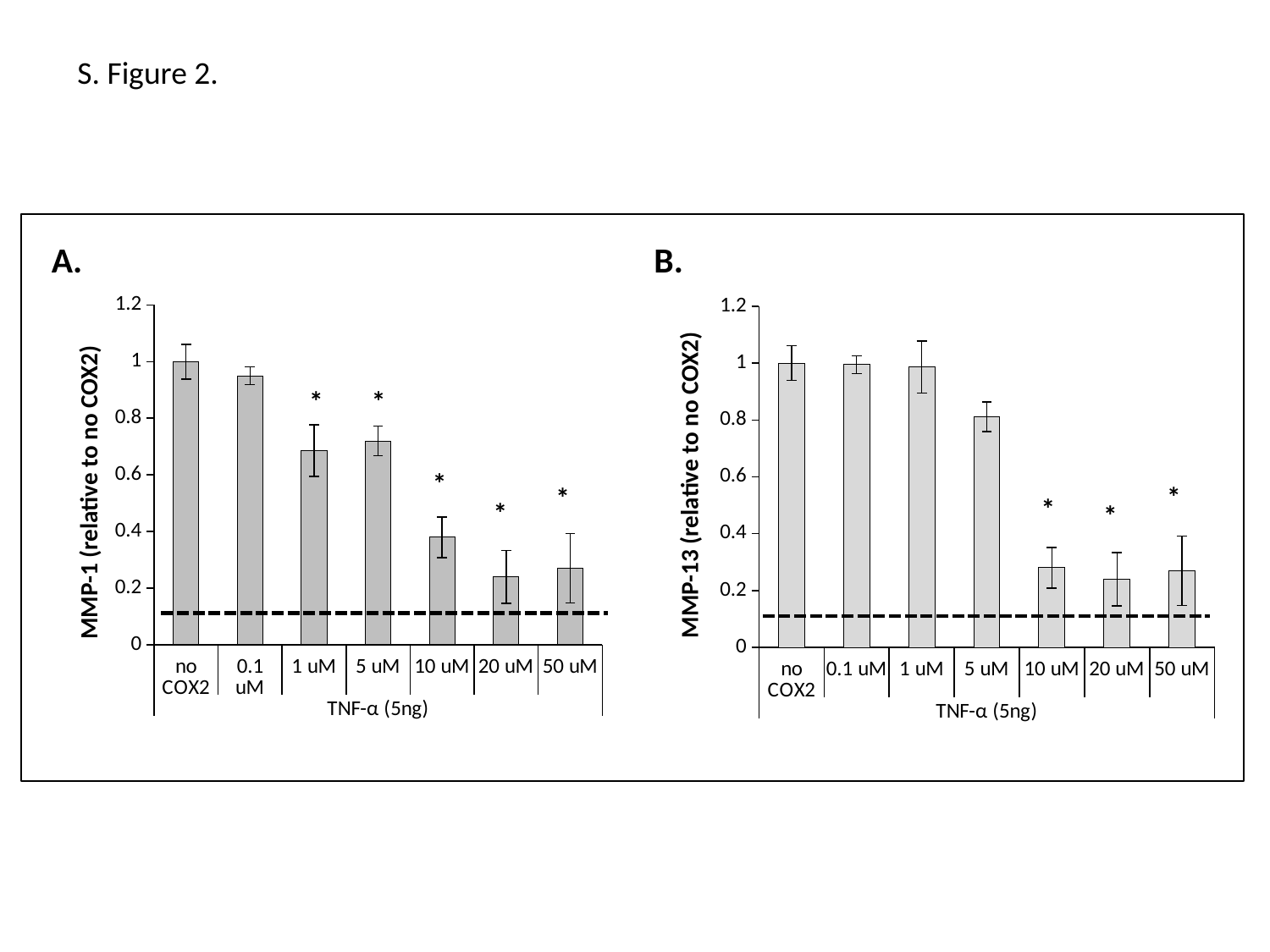
In chart B (MMP-13), do the bar values generally rise or fall from left to right along the x axis? fall In chart B (MMP-13), is the value for 10 uM greater or less than 0.4? less In chart A (MMP-1), is the value for 5 uM greater or less than 0.6? greater In chart B (MMP-13), is the value for 1 uM greater or less than 0.8? greater In chart B (MMP-13), what is the value for no COX2? 1 What is the y-axis title of chart A? MMP-1 (relative to no COX2) In chart A (MMP-1), what is the value for no COX2? 1 In chart A (MMP-1), which is larger, the value for 5 uM or the value for 10 uM? 5 uM What kind of chart is chart A (MMP-1)? bar chart How many categories are shown on the x axis of chart B (MMP-13)? 7 In chart B (MMP-13), which is larger, the value for 5 uM or the value for 20 uM? 5 uM